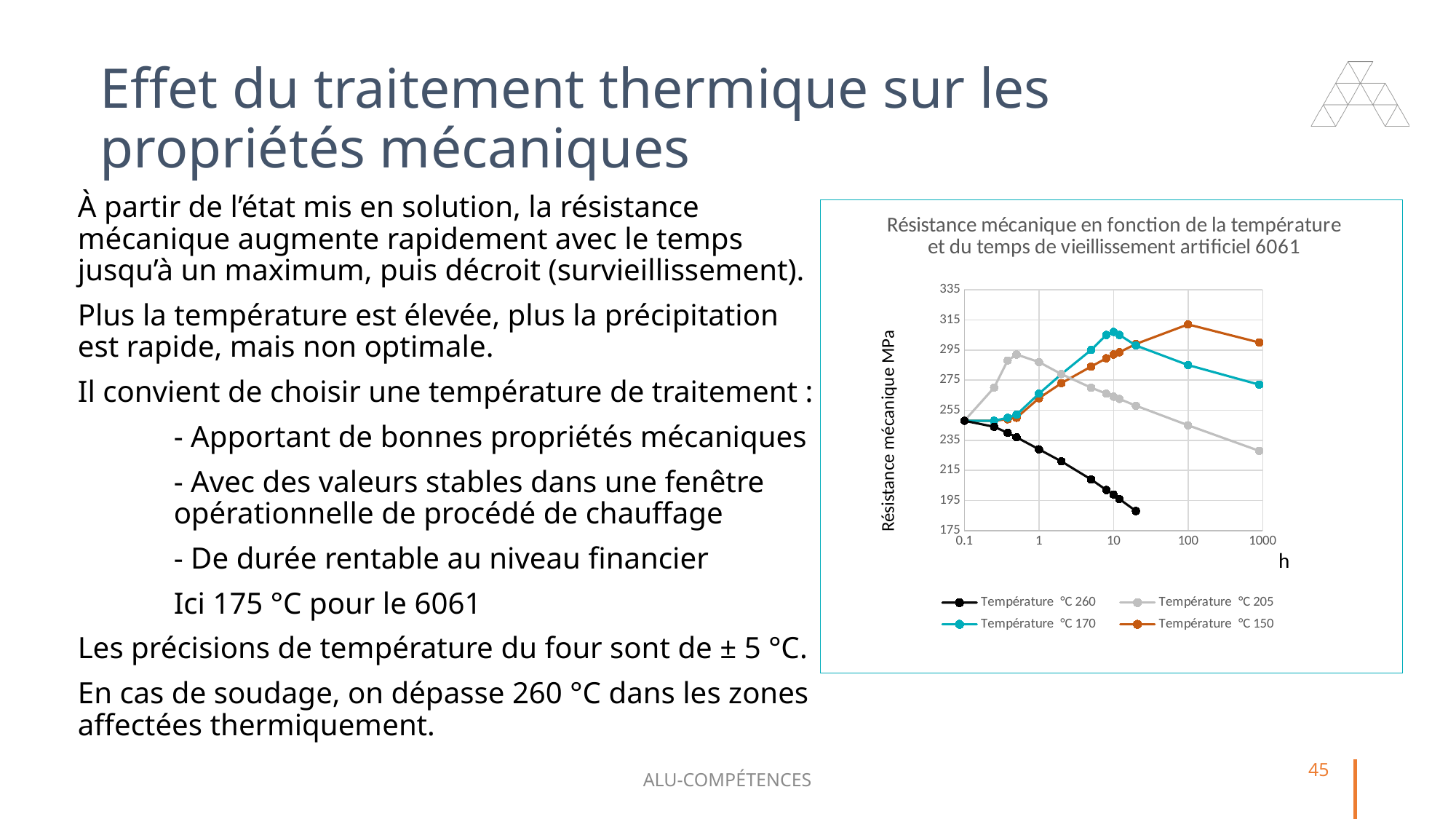
Is the value of the Température °C 205 series at 1000 h greater or less than 255? less Does the Température °C 260 series rise or fall as time increases along the x axis? fall At 1000 h, which series has the higher value: Température °C 150 or Température °C 170? Température °C 150 How many series does the legend of the chart list? 4 At 10 h, which series has the lowest value? Température °C 260 Is the value of the Température °C 150 series at 100 h greater or less than 295? greater Is the value of the Température °C 260 series at 10 h greater or less than 215? less What kind of chart is shown on the slide? line chart What is the label of the vertical axis of the chart? Résistance mécanique MPa What is the title of the chart? Résistance mécanique en fonction de la température et du temps de vieillissement artificiel 6061 At 1 h, which series has the highest value? Température °C 205